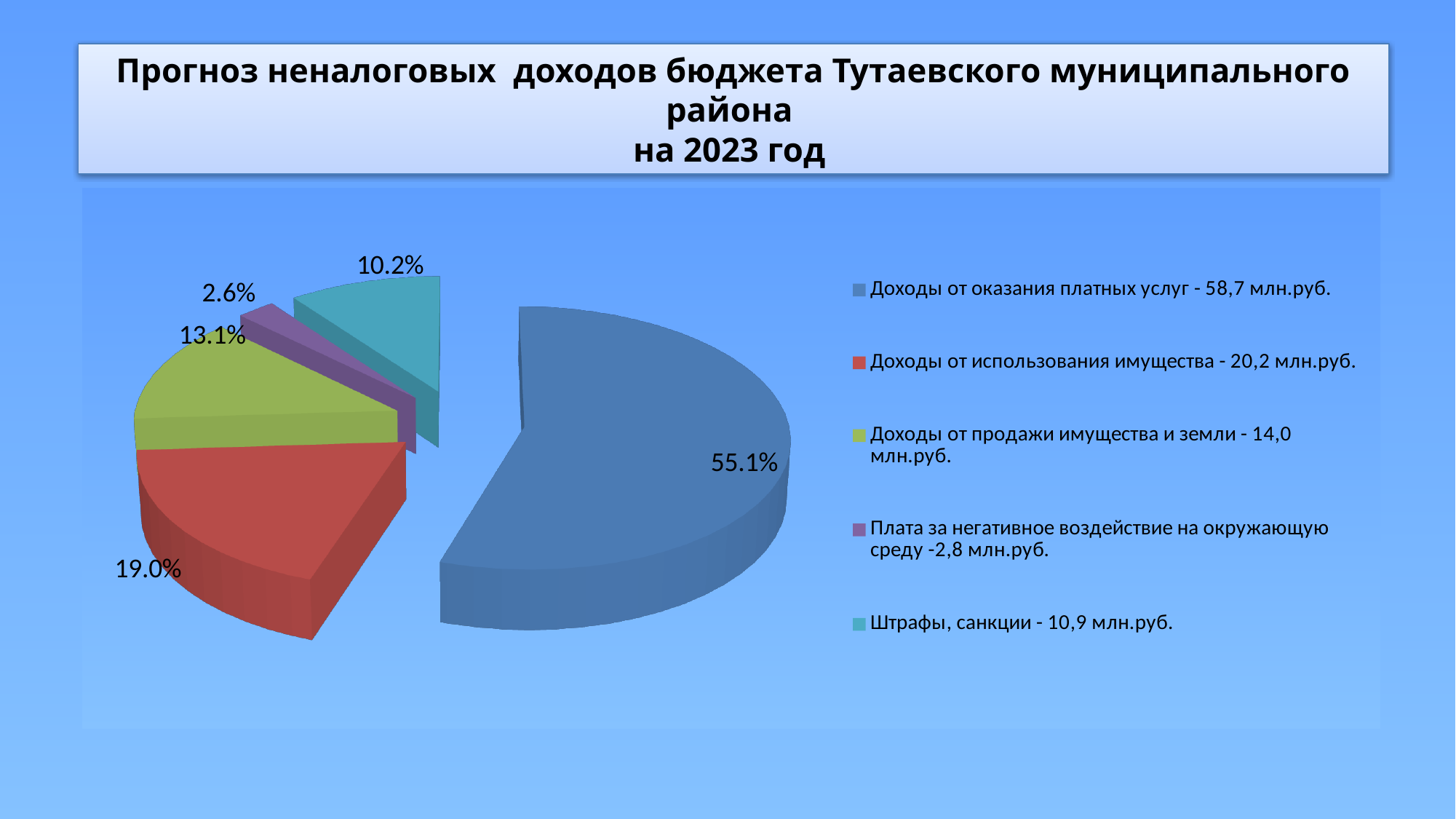
How many slices does the pie chart have? 5 According to the legend, what amount in млн.руб. corresponds to "Доходы от оказания платных услуг"? 58,7 млн.руб. What is the difference in percentage points between the slices for "Доходы от использования имущества" and "Доходы от продажи имущества и земли"? 5.9 What year does the chart title say the forecast is for? 2023 What share of the pie is labelled for "Доходы от использования имущества"? 19.0% What share of the pie is labelled for "Доходы от продажи имущества и земли"? 13.1% What share of the pie is labelled for "Доходы от оказания платных услуг"? 55.1% Which category has the largest slice of the pie? Доходы от оказания платных услуг Which slice is larger: "Штрафы, санкции" or "Плата за негативное воздействие на окружающую среду"? Штрафы, санкции What kind of chart is shown on the slide? Pie chart Which category has the smallest slice of the pie? Плата за негативное воздействие на окружающую среду